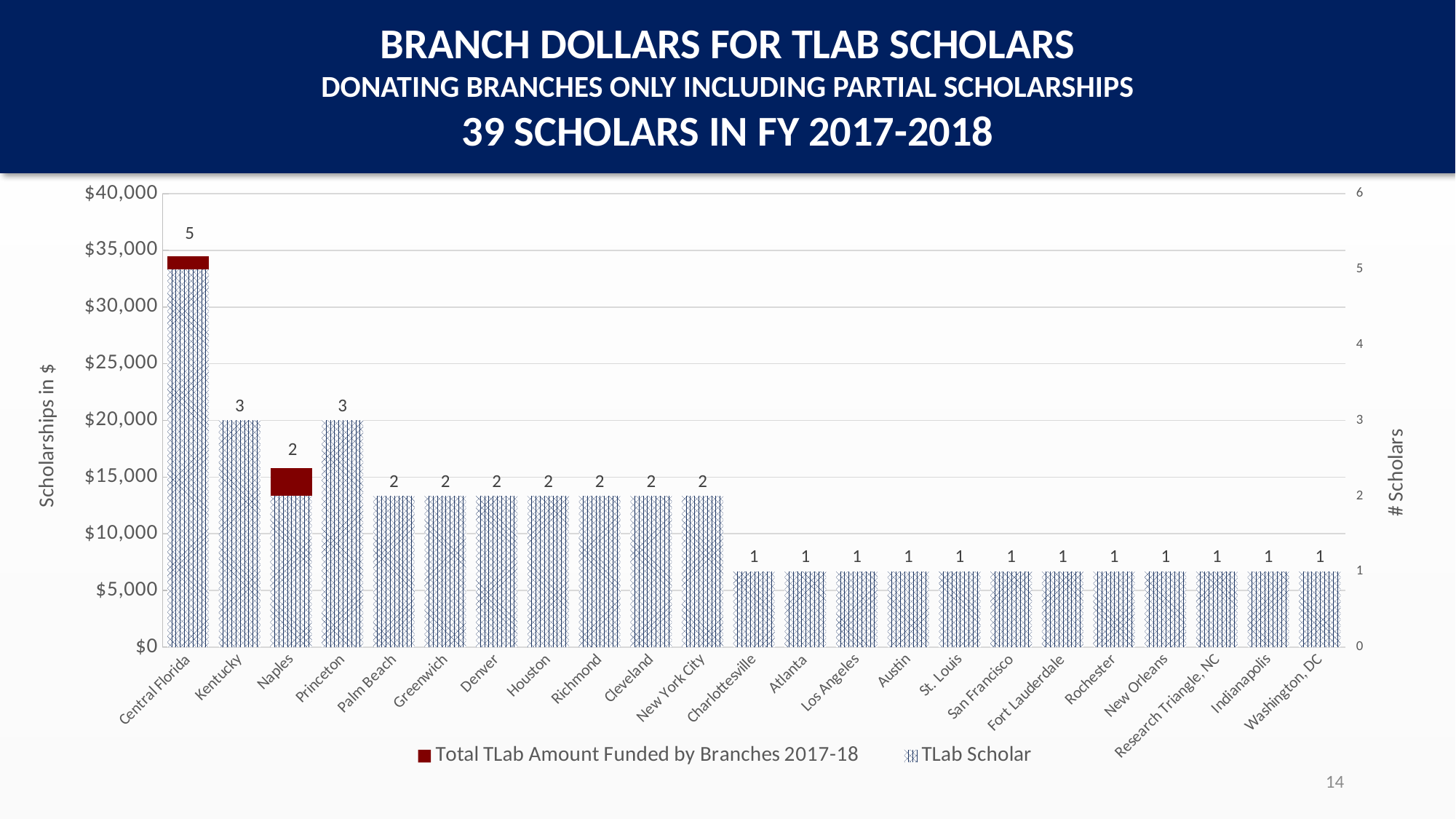
How many series does the chart legend list? 2 How many TLab Scholars does Washington, DC have? 1 How many TLab Scholars does Central Florida have? 5 How many branches are shown on the x axis of the chart? 23 Is the Total TLab Amount Funded by Branches 2017-18 for Naples greater or less than $10,000? greater Is the Total TLab Amount Funded by Branches 2017-18 for Central Florida greater or less than $30,000? greater How many TLab Scholars does Naples have? 2 What type of chart is shown on the slide? Bar chart Which branch has the highest number of TLab Scholars? Central Florida Which branch has more TLab Scholars, Kentucky or Palm Beach? Kentucky How many TLab Scholars does Kentucky have? 3 What is the difference in the number of TLab Scholars between Central Florida and Princeton? 2